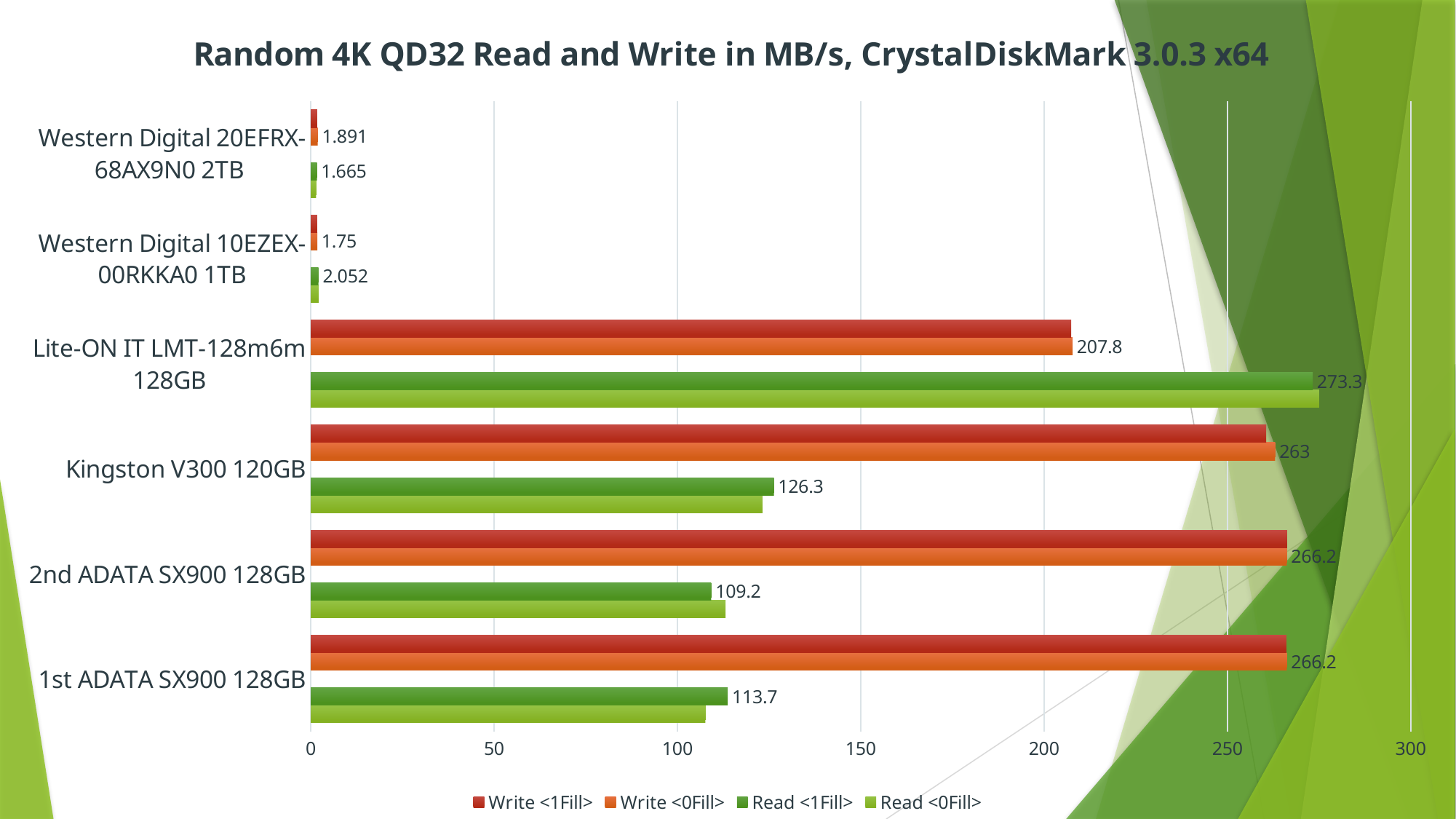
How many series does the legend list? 4 What is the Read <1Fill> value for the Kingston V300 120GB? 126.3 Which has the larger Read <1Fill> value, the 1st ADATA SX900 128GB or the 2nd ADATA SX900 128GB? 1st ADATA SX900 128GB What is the Read <1Fill> value for the Western Digital 20EFRX-68AX9N0 2TB? 1.665 What kind of chart is shown on the slide? bar chart Which drive has the highest Read <1Fill> value? Lite-ON IT LMT-128m6m 128GB What is the Write <0Fill> value for the Lite-ON IT LMT-128m6m 128GB? 207.8 Is the Write <1Fill> value for the Lite-ON IT LMT-128m6m 128GB greater or less than 250? less What is the title of the chart? Random 4K QD32 Read and Write in MB/s, CrystalDiskMark 3.0.3 x64 How many drives (categories) are plotted on the chart? 6 What is the difference between the Write <0Fill> values of the Kingston V300 120GB and the Lite-ON IT LMT-128m6m 128GB? 55.2 What is the Write <0Fill> value for the Western Digital 10EZEX-00RKKA0 1TB? 1.75